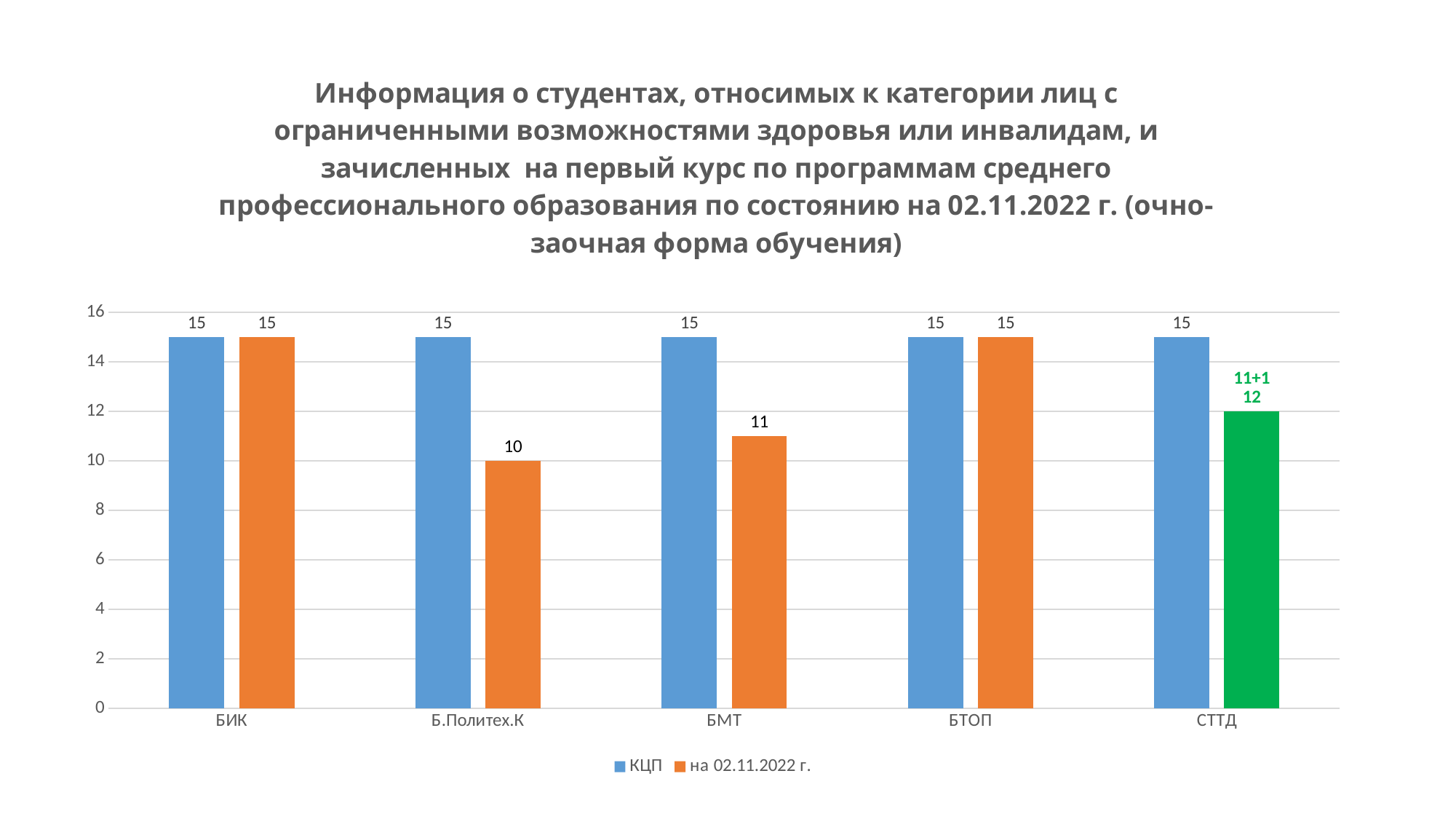
What type of chart is shown on the slide? bar chart What is the difference between the КЦП value and the 'на 02.11.2022 г.' value for БМТ? 4 How many series does the legend list? 2 What is the difference between the КЦП value and the 'на 02.11.2022 г.' value for Б.Политех.К? 5 What colour is the 'на 02.11.2022 г.' bar for СТТД? green What is the КЦП value for СТТД? 15 Is the 'на 02.11.2022 г.' value for СТТД greater or less than 14? less How many categories are shown on the x axis? 5 Which is larger for БМТ: the КЦП value or the 'на 02.11.2022 г.' value? КЦП Which category has the lowest value for 'на 02.11.2022 г.'? Б.Политех.К What is the value of 'на 02.11.2022 г.' for Б.Политех.К? 10 What is the value of 'на 02.11.2022 г.' for БМТ? 11